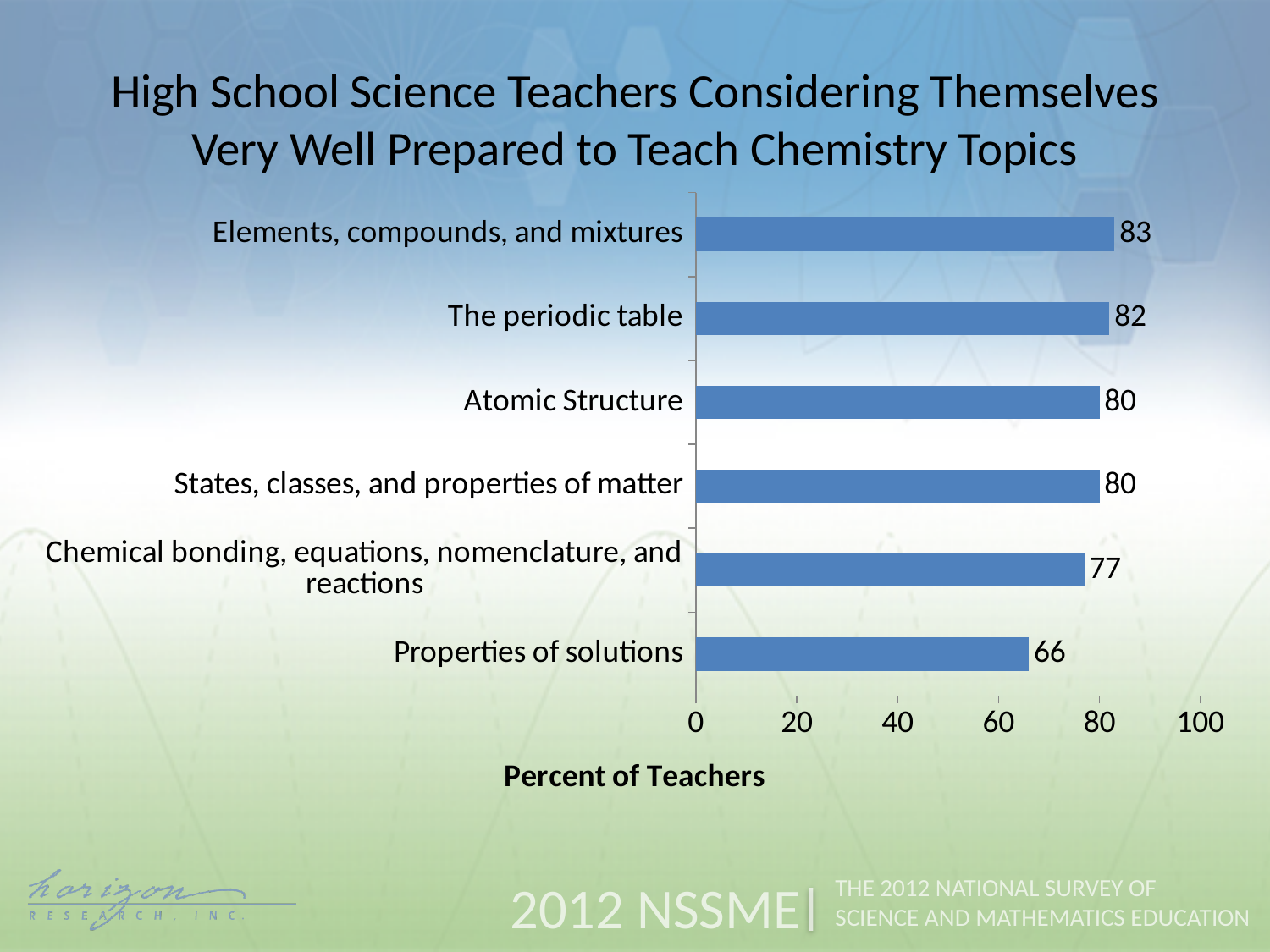
What is the value for Properties of solutions? 66 What percent of teachers consider themselves very well prepared to teach the periodic table? 82 How many chemistry topics are shown in the chart? 6 Which chemistry topic has the highest percent of teachers? Elements, compounds, and mixtures What kind of chart is shown on the slide? bar chart What is the value for Chemical bonding, equations, nomenclature, and reactions? 77 What is the difference between the values for Atomic Structure and Chemical bonding, equations, nomenclature, and reactions? 3 Which chemistry topic has the lowest percent of teachers? Properties of solutions Which is larger, the value for The periodic table or the value for Properties of solutions? The periodic table Is the value for Properties of solutions greater or less than 80? less What is the label of the horizontal axis? Percent of Teachers What is the difference between the values for Elements, compounds, and mixtures and Properties of solutions? 17